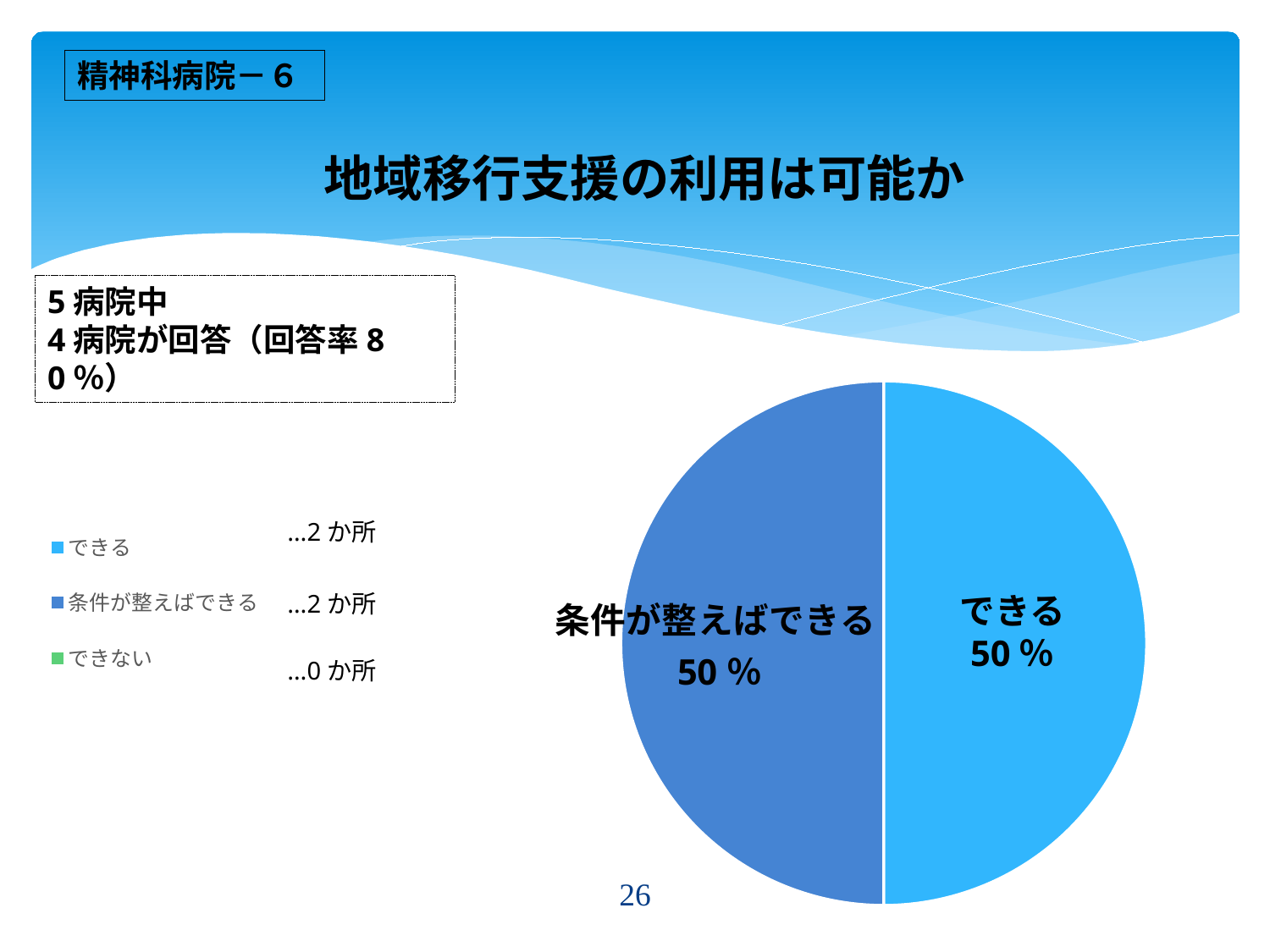
What share of the pie does the 条件が整えばできる slice represent? 50％ What is the title of the chart on the slide? 地域移行支援の利用は可能か How many hospitals answered できない according to the legend? 0か所 Which category in the legend is shown in green? できない How many hospitals answered 条件が整えばできる according to the legend? 2か所 What share of the pie does the できる slice represent? 50％ How many categories does the legend list? 3 How many hospitals answered できる according to the legend? 2か所 What is the difference between the number of hospitals answering できる and those answering できない? 2か所 What kind of chart is shown on the slide? pie chart What is the total number of hospitals across the three legend categories? 4か所